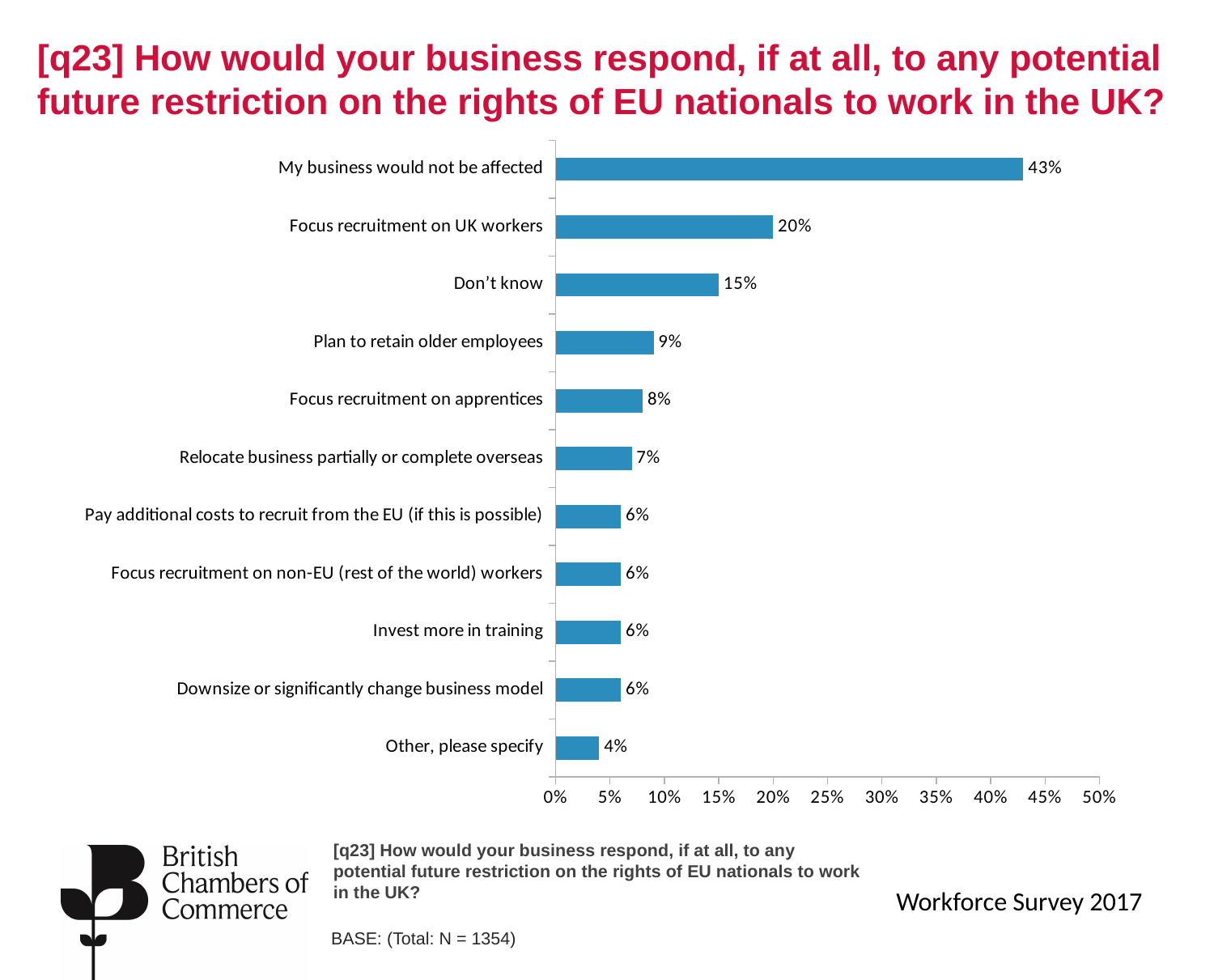
How many response categories are shown in the chart? 11 What is the difference in percentage points between 'My business would not be affected' and 'Focus recruitment on UK workers'? 23 percentage points What percentage of respondents answered 'Don't know'? 15% What percentage of respondents said their business would not be affected? 43% What is the base (sample size) stated on the slide? N = 1354 What type of chart is shown on the slide? Bar chart Which is larger: 'Plan to retain older employees' or 'Focus recruitment on apprentices'? Plan to retain older employees What is the value for 'Relocate business partially or complete overseas'? 7% Which response has the lowest percentage? Other, please specify Is the value for 'Don't know' greater or less than 10%? greater What is the value for 'Focus recruitment on UK workers'? 20% Which response has the highest percentage? My business would not be affected